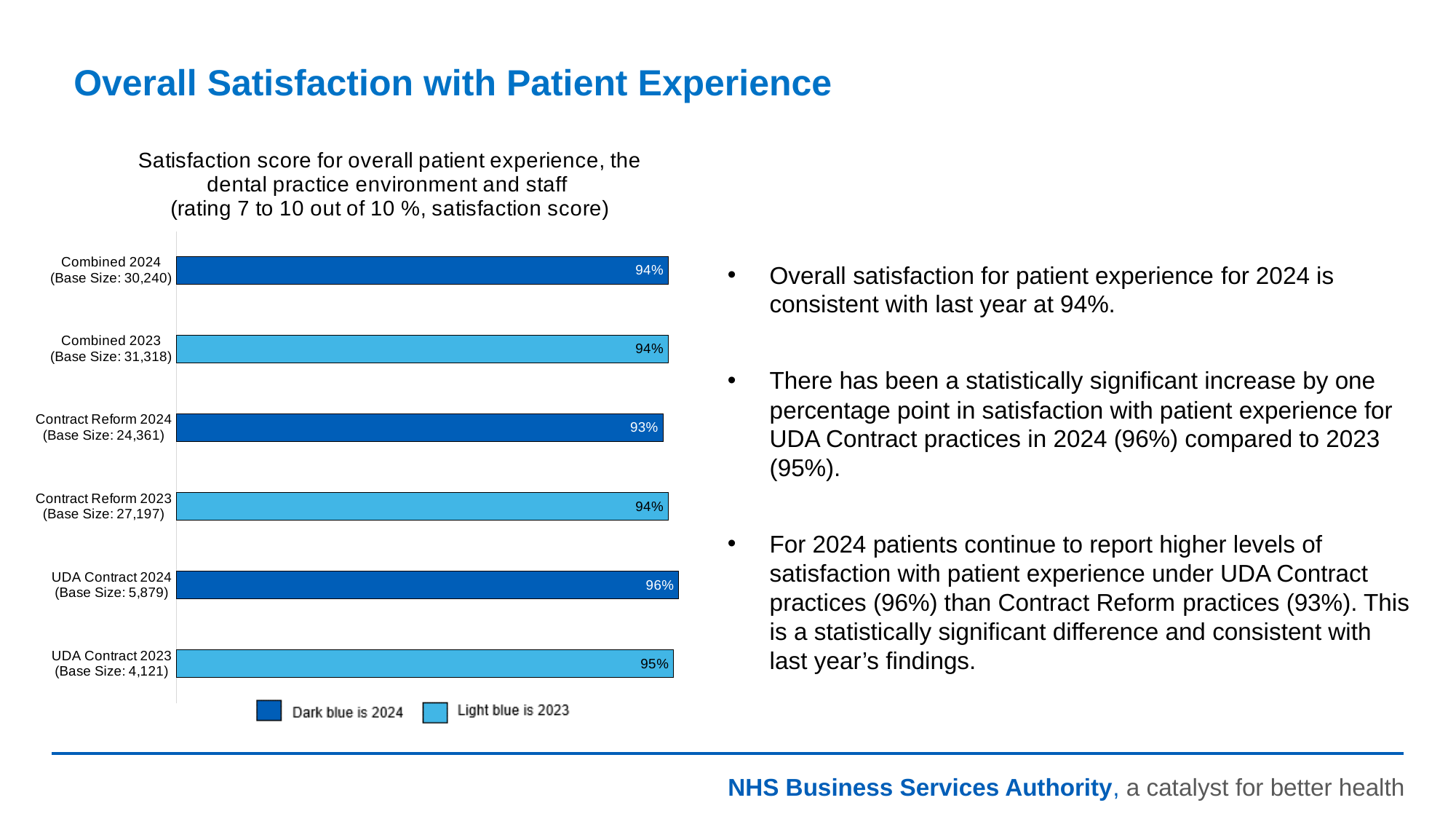
What is the satisfaction score for UDA Contract 2023? 95% Which category has the highest satisfaction score? UDA Contract 2024 What is the satisfaction score for Contract Reform 2023? 94% What is the difference between the satisfaction scores for UDA Contract 2024 and UDA Contract 2023? 1% Which category has the lowest satisfaction score? Contract Reform 2024 How many bars are shown in the chart? 6 What is the satisfaction score for Contract Reform 2024? 93% What is the satisfaction score for Combined 2024? 94% What is the base size shown for Combined 2024? 30,240 Which has a higher satisfaction score, UDA Contract 2024 or Contract Reform 2023? UDA Contract 2024 What is the difference between the satisfaction scores for UDA Contract 2024 and Contract Reform 2024? 3% What type of chart is shown on the slide? Bar chart